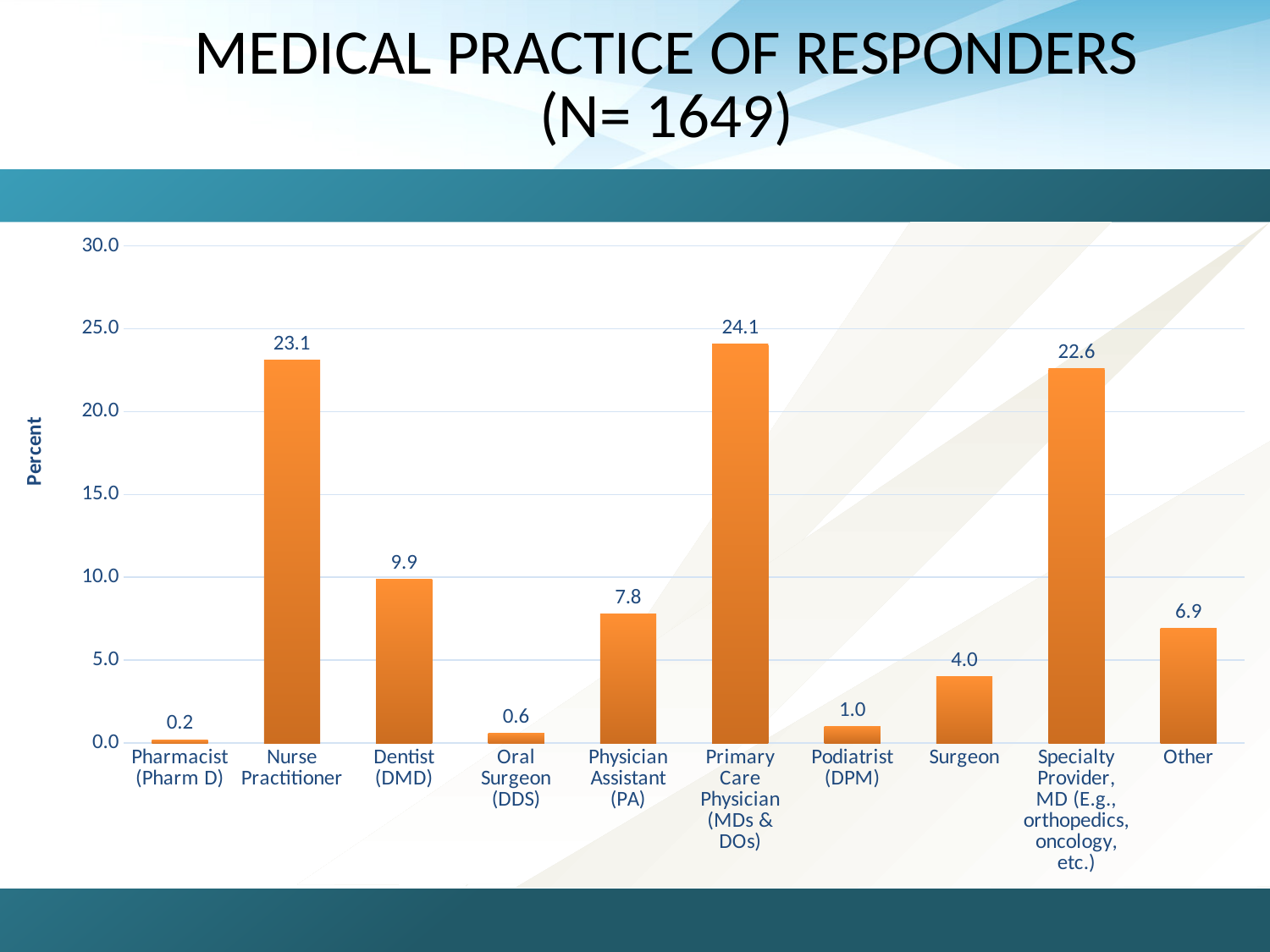
What is the value for Nurse Practitioner? 23.1 Which category has the highest value? Primary Care Physician (MDs & DOs) What is the title of the slide? MEDICAL PRACTICE OF RESPONDERS (N= 1649) Which is larger, the value for Physician Assistant (PA) or the value for Other? Physician Assistant (PA) Which category has the lowest value? Pharmacist (Pharm D) How many categories are shown on the x axis? 10 What kind of chart is shown on the slide? bar chart What is the value for Dentist (DMD)? 9.9 What is the label of the vertical axis? Percent What is the difference between the values for Primary Care Physician (MDs & DOs) and Specialty Provider, MD? 1.5 Is the value for Dentist (DMD) greater or less than 10.0? less What is the value for Surgeon? 4.0